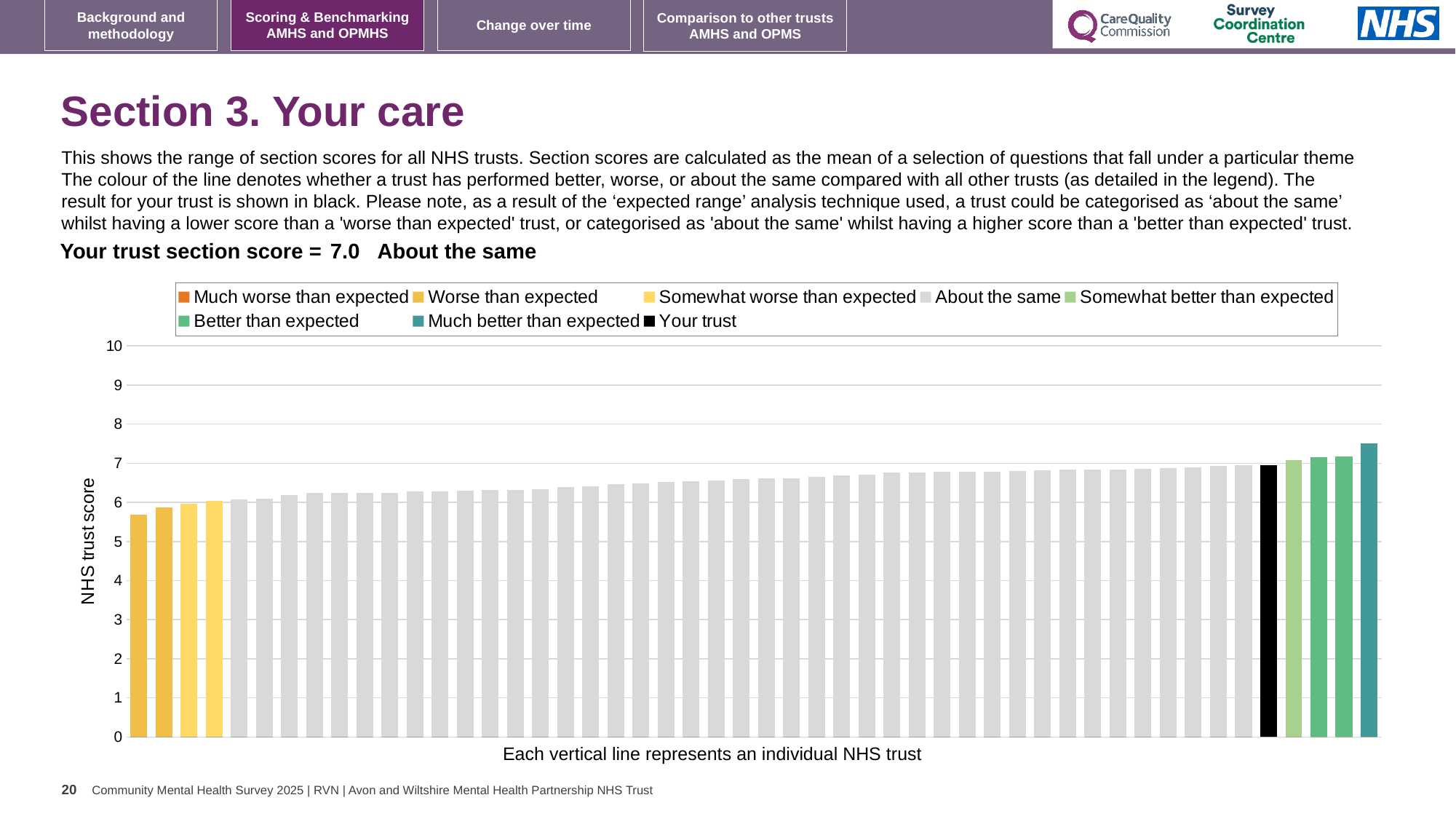
What is the label on the vertical axis? NHS trust score What colour is the bar representing your trust? black Which category is your trust placed in for this section? About the same Is the value for your trust (the black bar) greater or less than 6? greater Is the value of the highest bar greater or less than 7? greater How many bars are coloured as 'Better than expected'? 2 How many entries does the chart legend list? 8 What kind of chart is shown on the slide? bar chart What is the section score for your trust? 7.0 Is the value of the lowest bar greater or less than 6? less How many bars are coloured as 'Much better than expected'? 1 Do the bar values rise or fall from left to right along the x axis? rise